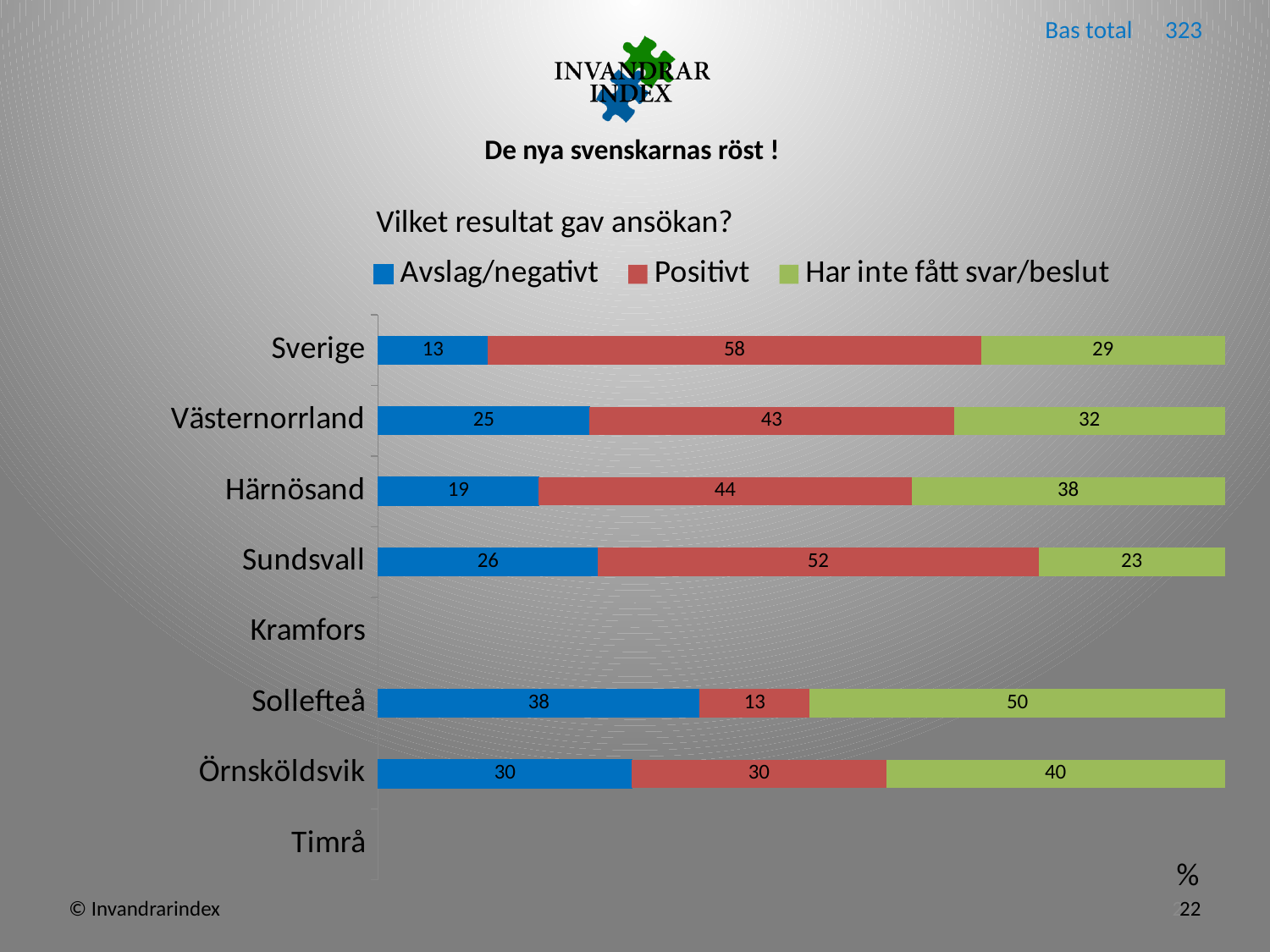
Which is larger, the Har inte fått svar/beslut value for Sollefteå or for Örnsköldsvik? Sollefteå What is the total of the stacked bar for Örnsköldsvik? 100 How many series does the legend list? 3 What is the Positivt value for Sverige? 58 What is the title of the chart? Vilket resultat gav ansökan? What is the Har inte fått svar/beslut value for Härnösand? 38 Which category has the lowest Avslag/negativt value? Sverige What is the difference between the Positivt values for Sundsvall and Västernorrland? 9 Which categories on the axis have no bars plotted? Kramfors and Timrå What kind of chart is shown on the slide? Stacked bar chart Which category has the highest Positivt value? Sverige What is the Avslag/negativt value for Sollefteå? 38